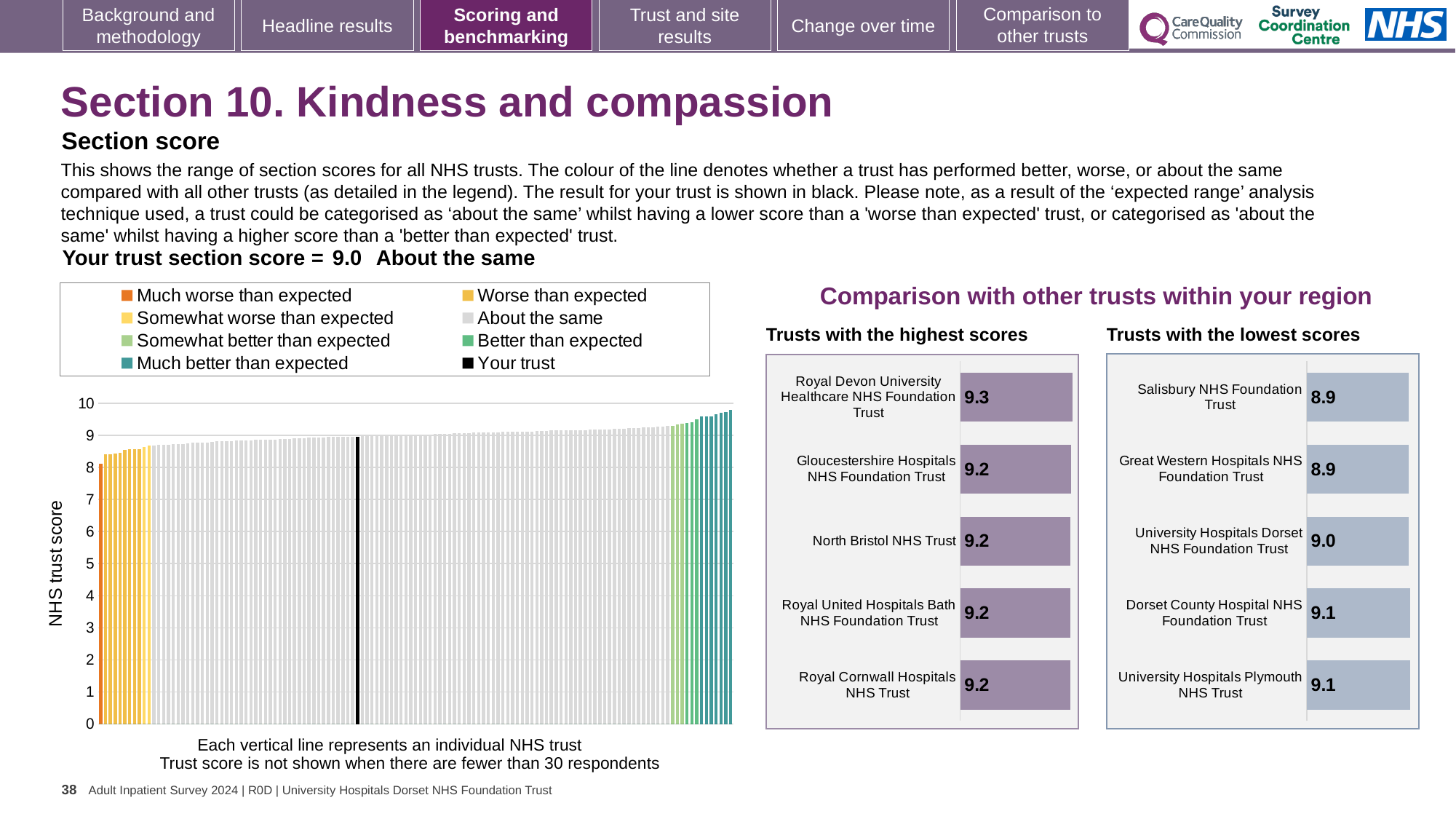
In the 'Trusts with the highest scores' chart, how many trusts are listed? 5 In the 'Trusts with the highest scores' chart, what is the score for Royal Devon University Healthcare NHS Foundation Trust? 9.3 What kind of chart is the large chart on the left showing NHS trust scores? bar chart In the large chart on the left, is the value of the black bar (your trust) greater or less than 8? greater In the 'Trusts with the lowest scores' chart, which has the larger score: Dorset County Hospital NHS Foundation Trust or Great Western Hospitals NHS Foundation Trust? Dorset County Hospital NHS Foundation Trust In the 'Trusts with the highest scores' chart, what is the difference between the scores of Royal Devon University Healthcare NHS Foundation Trust and North Bristol NHS Trust? 0.1 In the 'Trusts with the lowest scores' chart, what is the score for Salisbury NHS Foundation Trust? 8.9 In the 'Trusts with the lowest scores' chart, do the scores rise or fall going from the top trust to the bottom trust? rise In the 'Trusts with the lowest scores' chart, what is the difference between the scores of University Hospitals Plymouth NHS Trust and Salisbury NHS Foundation Trust? 0.2 In the 'Trusts with the lowest scores' chart, what is the score for University Hospitals Dorset NHS Foundation Trust? 9.0 How many entries does the legend of the large chart on the left list? 8 In the 'Trusts with the highest scores' chart, which trust has the highest score? Royal Devon University Healthcare NHS Foundation Trust